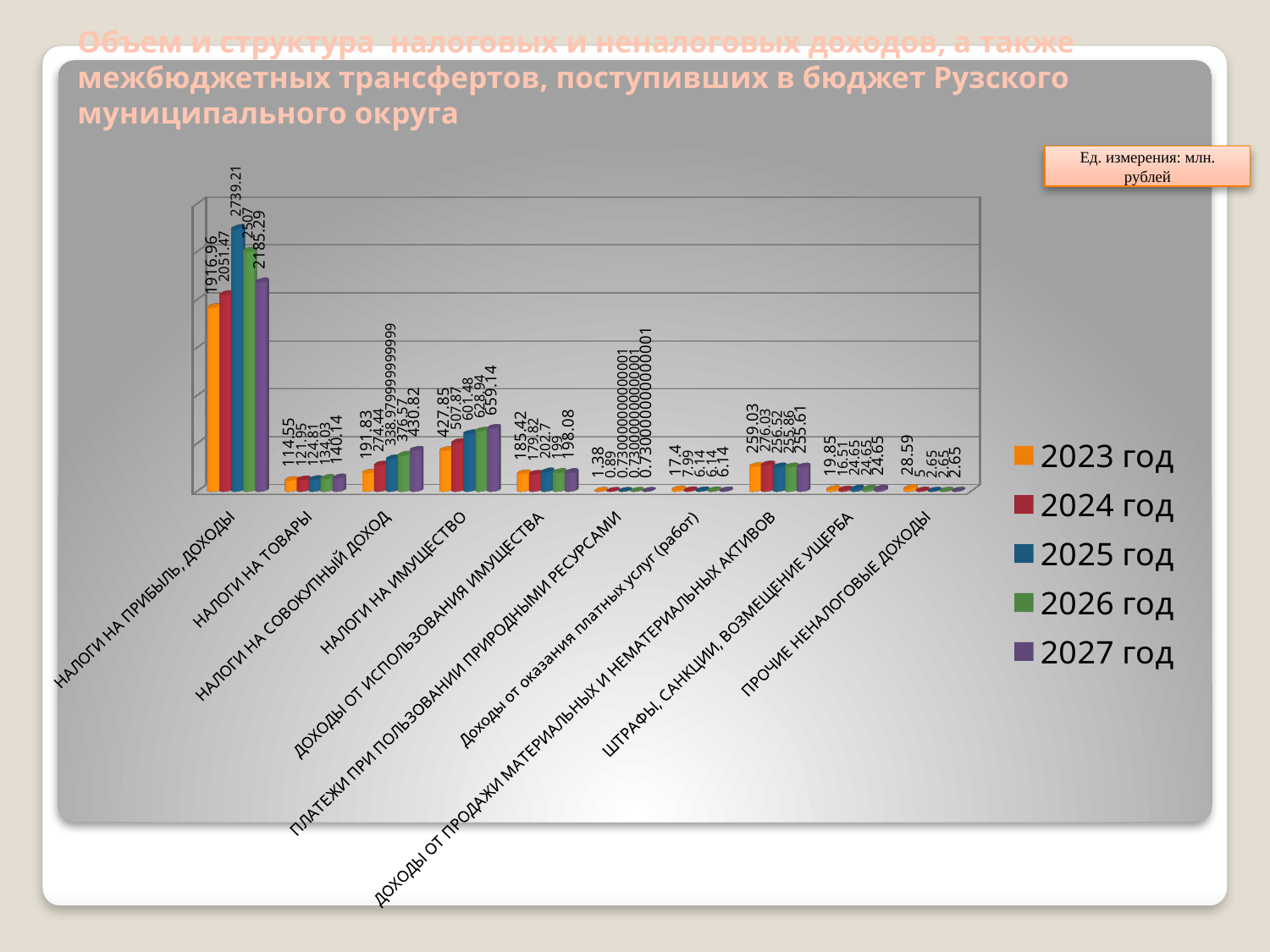
By how much does НАЛОГИ НА ИМУЩЕСТВО in 2024 год exceed its 2023 год value? 80.02 What is the difference between the 2027 год and 2023 год values for НАЛОГИ НА ТОВАРЫ? 25.59 Which year has the highest value for НАЛОГИ НА ПРИБЫЛЬ, ДОХОДЫ? 2025 год What is the value for НАЛОГИ НА ТОВАРЫ in 2025 год? 124.81 What is the value for НАЛОГИ НА ИМУЩЕСТВО in 2027 год? 659.14 Do the values for НАЛОГИ НА ИМУЩЕСТВО rise or fall from 2023 год to 2027 год? rise How many categories are shown on the x axis of the chart? 10 Which year has the lowest value for НАЛОГИ НА ТОВАРЫ? 2023 год What kind of chart is shown on the slide? bar chart What is the value for НАЛОГИ НА ПРИБЫЛЬ, ДОХОДЫ in 2023 год? 1916.96 For ДОХОДЫ ОТ ПРОДАЖИ МАТЕРИАЛЬНЫХ И НЕМАТЕРИАЛЬНЫХ АКТИВОВ, which is larger: the 2023 год value or the 2024 год value? 2024 год How many series does the legend list? 5